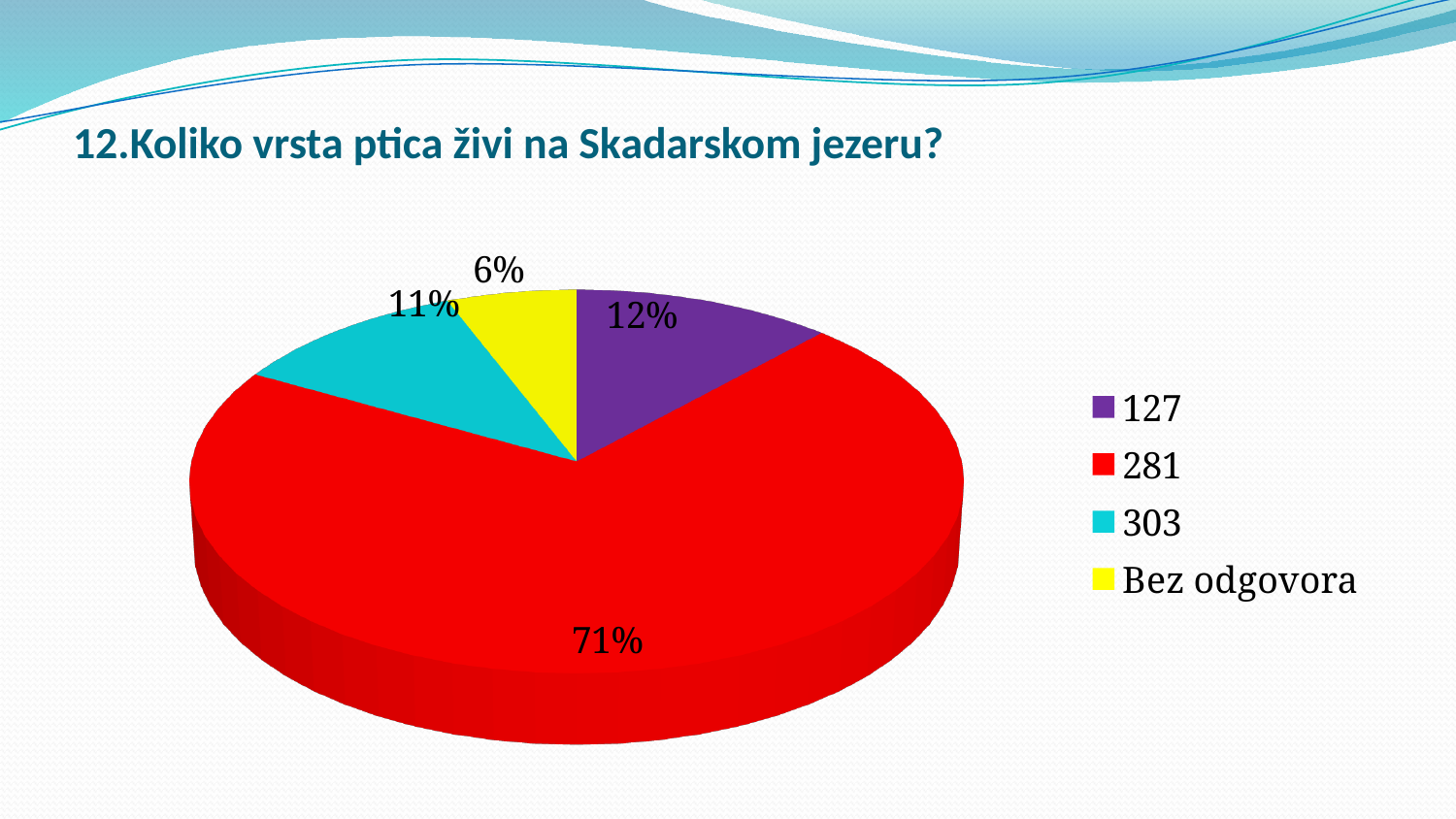
Which category has the largest slice of the pie? 281 Which category has the smallest slice of the pie? Bez odgovora What share of the pie does the "127" slice represent? 12% Which slice is larger, "127" or "303"? 127 What colour is the "Bez odgovora" slice? yellow What kind of chart is shown on the slide? pie chart What share of the pie does the "303" slice represent? 11% What share of the pie does the "281" slice represent? 71% What is the difference in percentage points between the "281" slice and the "127" slice? 59 How many categories does the legend list? 4 What is the title of the slide above the chart? 12.Koliko vrsta ptica živi na Skadarskom jezeru?